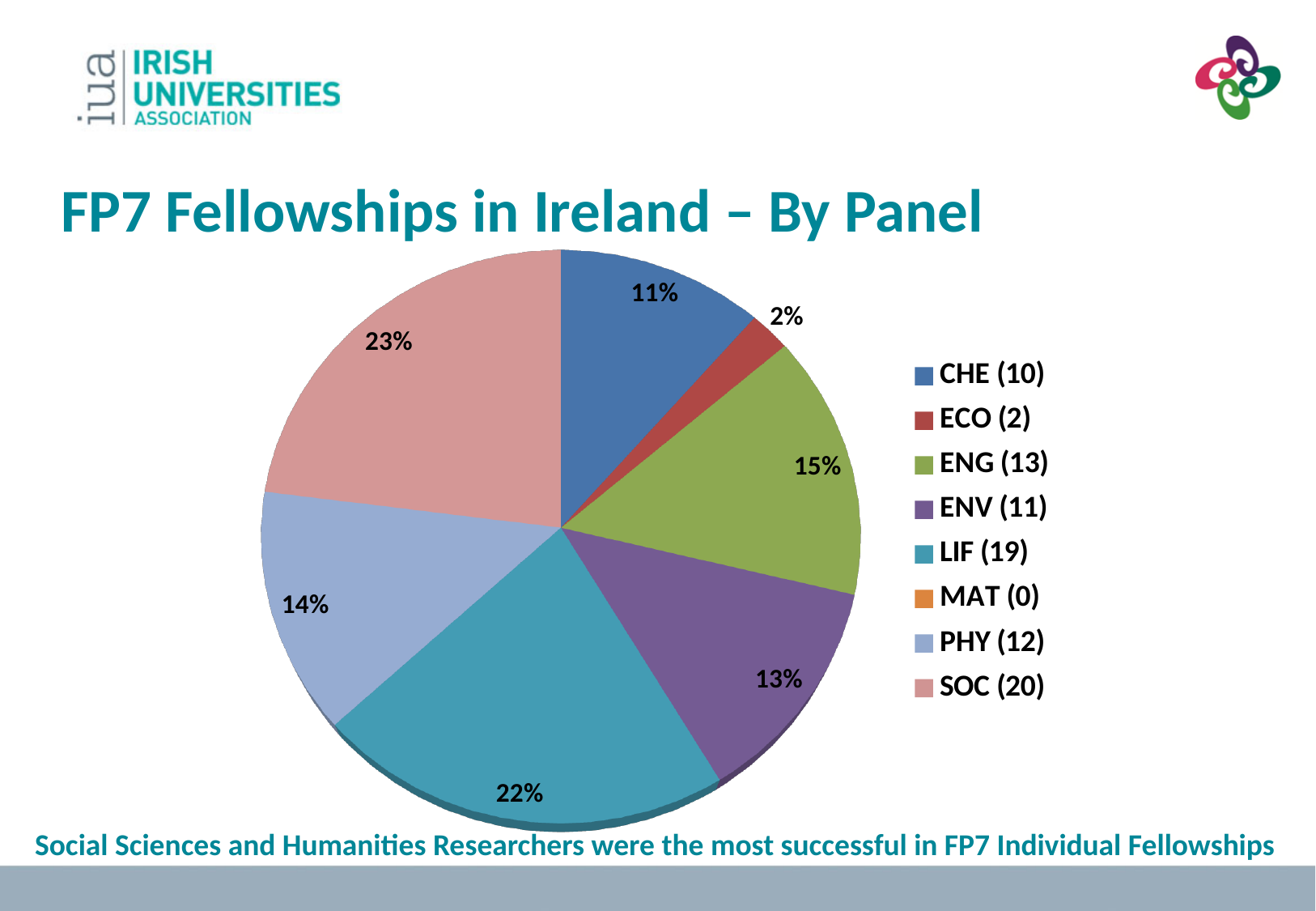
How many fellowships does the legend show for MAT? 0 How many fellowships does the legend show for LIF? 19 What kind of chart is shown on the slide? pie chart Which panel with a visible slice has the smallest share of the pie? ECO Which has a larger share of the pie, ENG or PHY? ENG What is the difference in fellowship count between SOC and CHE according to the legend? 10 What percentage share of the pie does LIF have? 22% Which panel has the largest share of the pie? SOC What percentage share of the pie does ECO have? 2% How many entries does the legend list? 8 What percentage share of the pie does SOC have? 23% What is the title of the chart on the slide? FP7 Fellowships in Ireland – By Panel